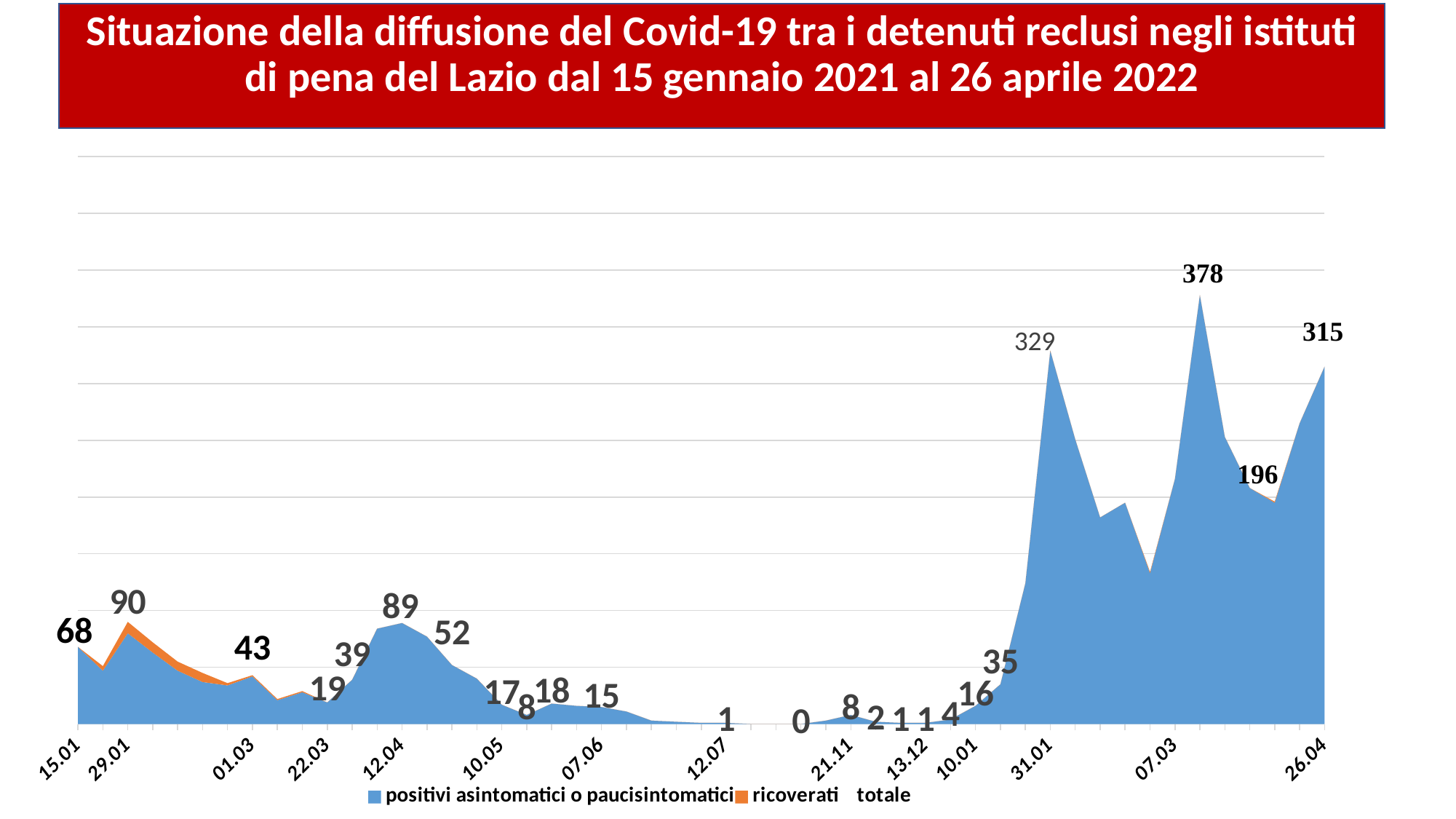
What is the value shown for 15.01? 68 What kind of chart is shown on the slide? area chart What is the value shown for 26.04? 315 What is the value shown for 01.03? 43 What is the value shown for 31.01? 329 What is the value shown for 12.04? 89 What is the value shown for 12.07? 1 Which is larger, the value at 31.01 or the peak labelled 378? 378 What is the highest value labelled on the chart? 378 How many series does the legend list? 3 What is the difference between the value at 29.01 (90) and the value at 15.01 (68)? 22 What is the difference between the highest labelled value (378) and the value at 26.04 (315)? 63